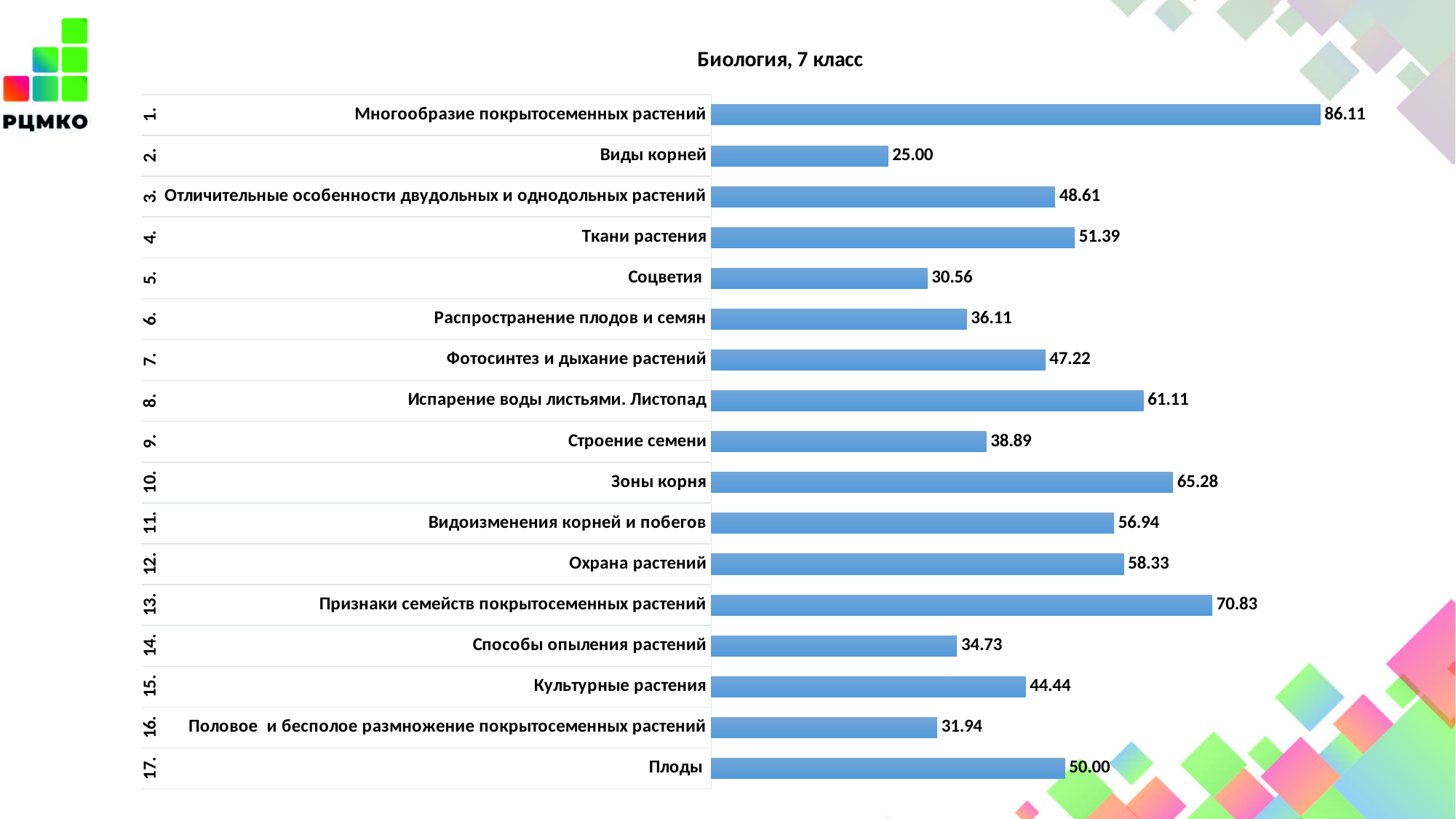
What kind of chart is shown on the slide? Bar chart Which category has the lowest value? Виды корней What is the title of the chart? Биология, 7 класс What is the value for «Испарение воды листьями. Листопад»? 61.11 Which category has the highest value? Многообразие покрытосеменных растений What is the value for «Зоны корня»? 65.28 How many categories are shown in the chart? 17 What is the difference between the values for «Многообразие покрытосеменных растений» and «Виды корней»? 61.11 What is the difference between the values for «Признаки семейств покрытосеменных растений» and «Плоды»? 20.83 Which is larger: the value for «Охрана растений» or the value for «Видоизменения корней и побегов»? Охрана растений Which is larger: the value for «Соцветия» or the value for «Строение семени»? Строение семени What is the value for «Виды корней»? 25.00